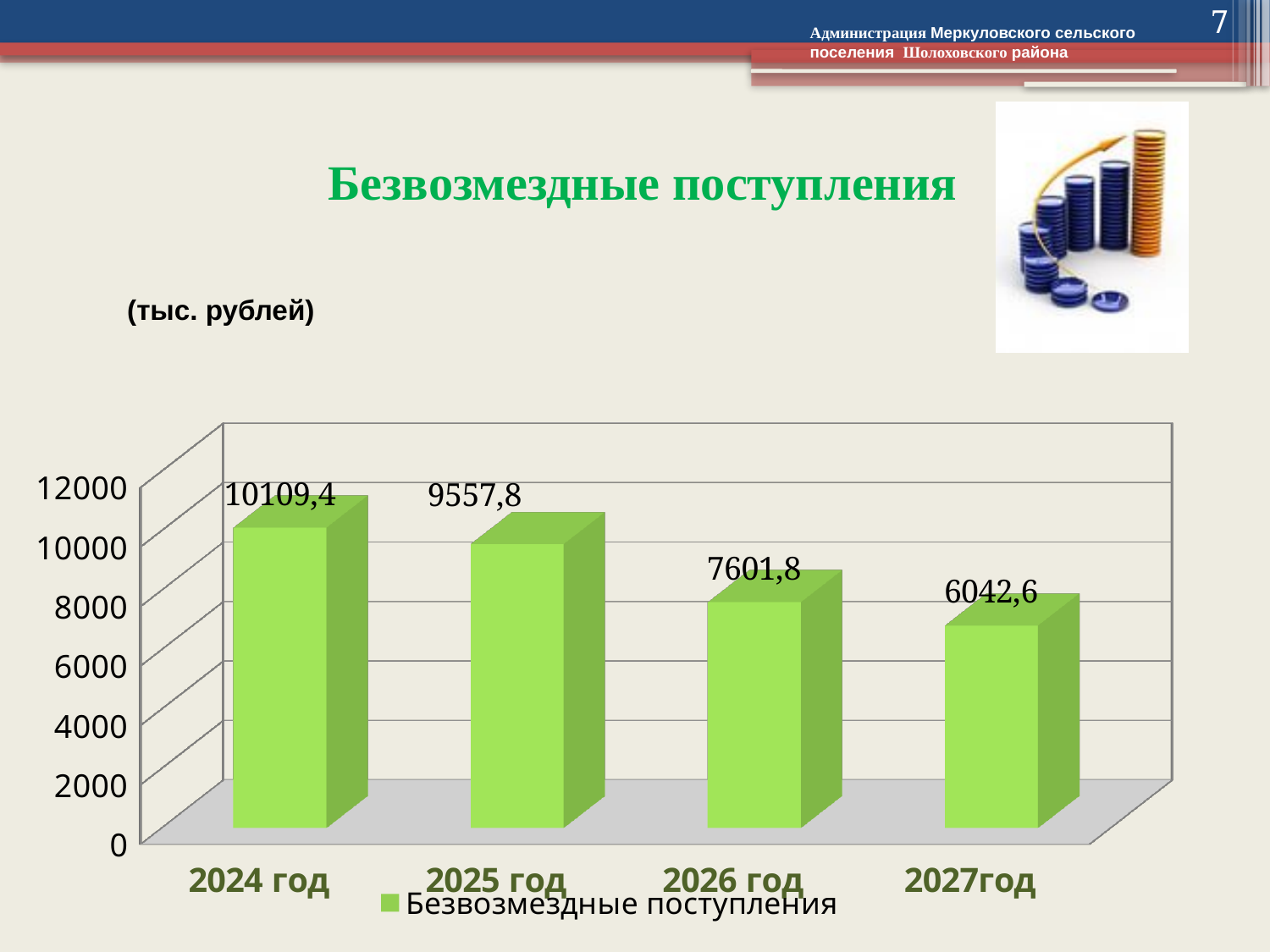
What is the value for 2026 год? 7601,8 What is the difference between the values for 2024 год and 2025 год? 551,6 Which year has the lowest value? 2027год What kind of chart is shown on the slide? bar chart How many years are shown on the chart? 4 What is the value for 2024 год? 10109,4 What is the value for 2027год? 6042,6 What is the value for 2025 год? 9557,8 What is the difference between the values for 2024 год and 2027год? 4066,8 Which is larger, the value for 2026 год or the value for 2027год? 2026 год Which year has the highest value? 2024 год Do the values rise or fall from 2024 год to 2027год? fall